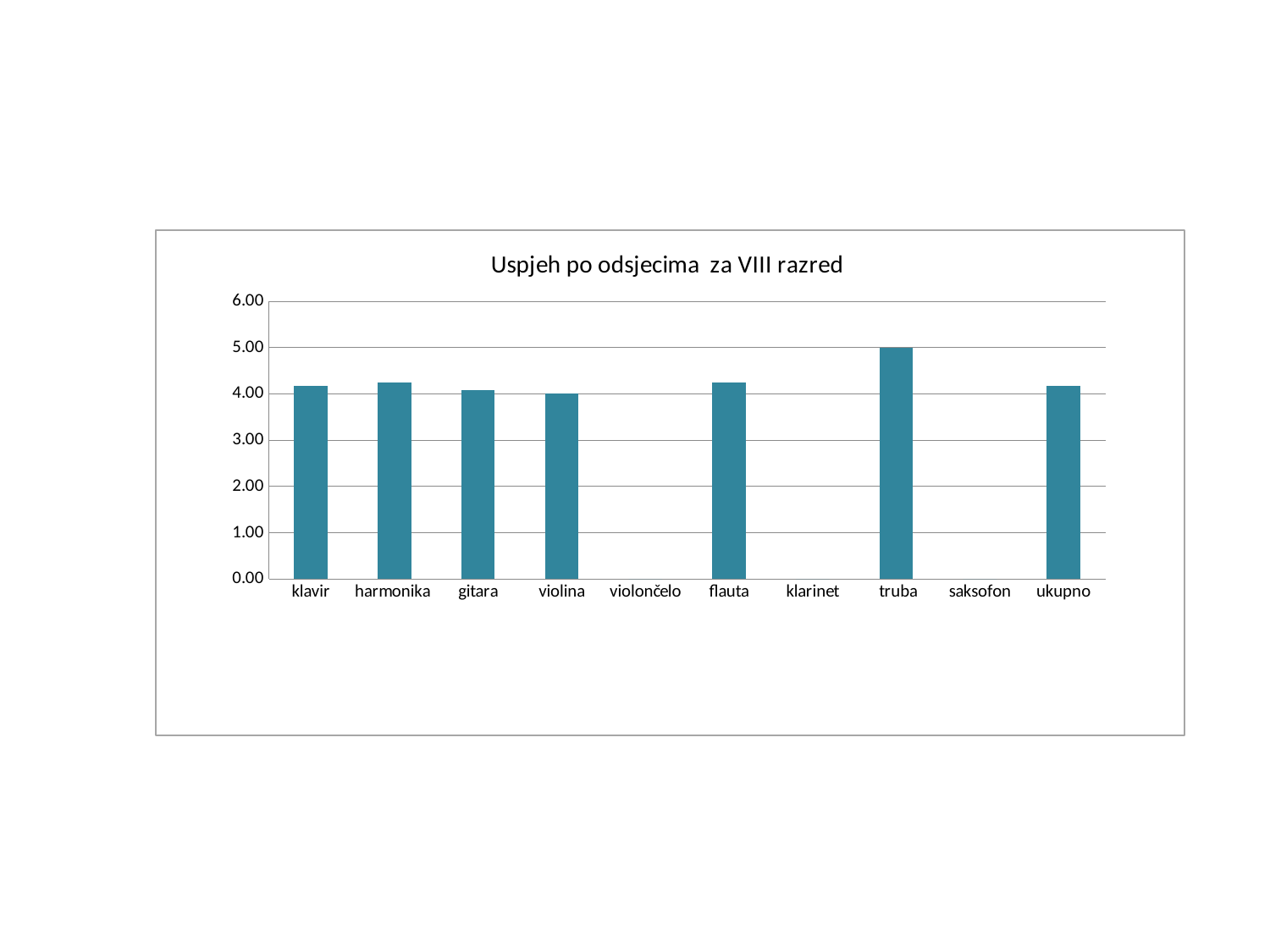
Which is larger, the value for truba or the value for klavir? truba Which category has the highest bar in the chart? truba Which is larger, the value for harmonika or the value for gitara? harmonika Which categories on the x axis have no bar shown? violončelo, klarinet, saksofon What is the title of the chart? Uspjeh po odsjecima za VIII razred Is the value for gitara greater or less than 3.00? greater Is the value for klavir greater or less than 4.00? greater Is the value for harmonika greater or less than 5.00? less What kind of chart is shown on the slide? bar chart What is the value for truba? 5.00 How many categories are shown on the x axis of the chart? 10